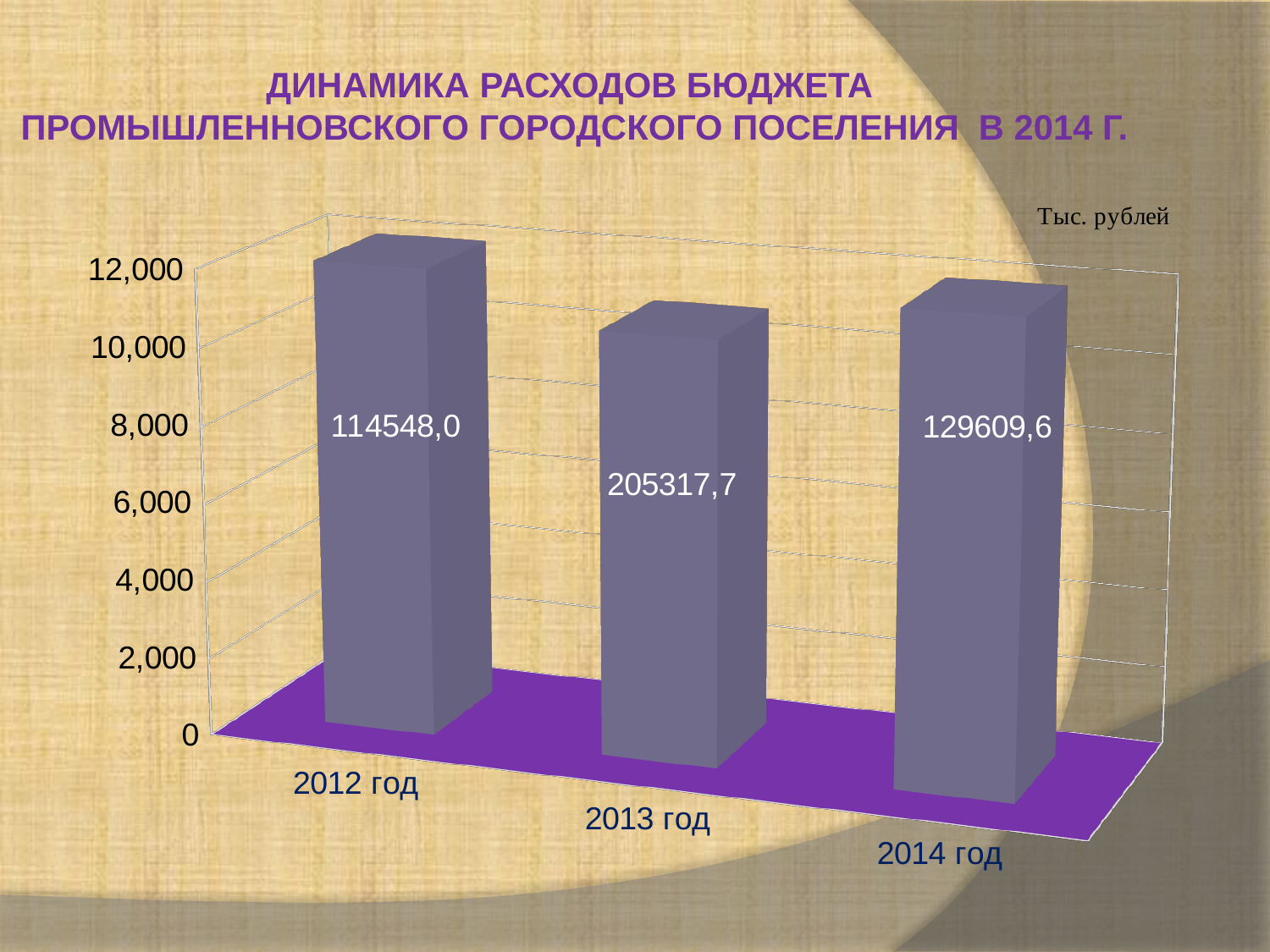
What is the value for 2014 год? 129609,6 What kind of chart is shown on the slide? Bar chart What is the difference between the values for 2014 год and 2012 год? 15061,6 What is the value for 2013 год? 205317,7 What is the value for 2012 год? 114548,0 How many years are shown on the chart? 3 What is the highest value shown on the vertical axis? 12,000 What unit is indicated for the values on the chart? Тыс. рублей What is the difference between the values for 2013 год and 2014 год? 75708,1 What is the difference between the values for 2013 год and 2012 год? 90769,7